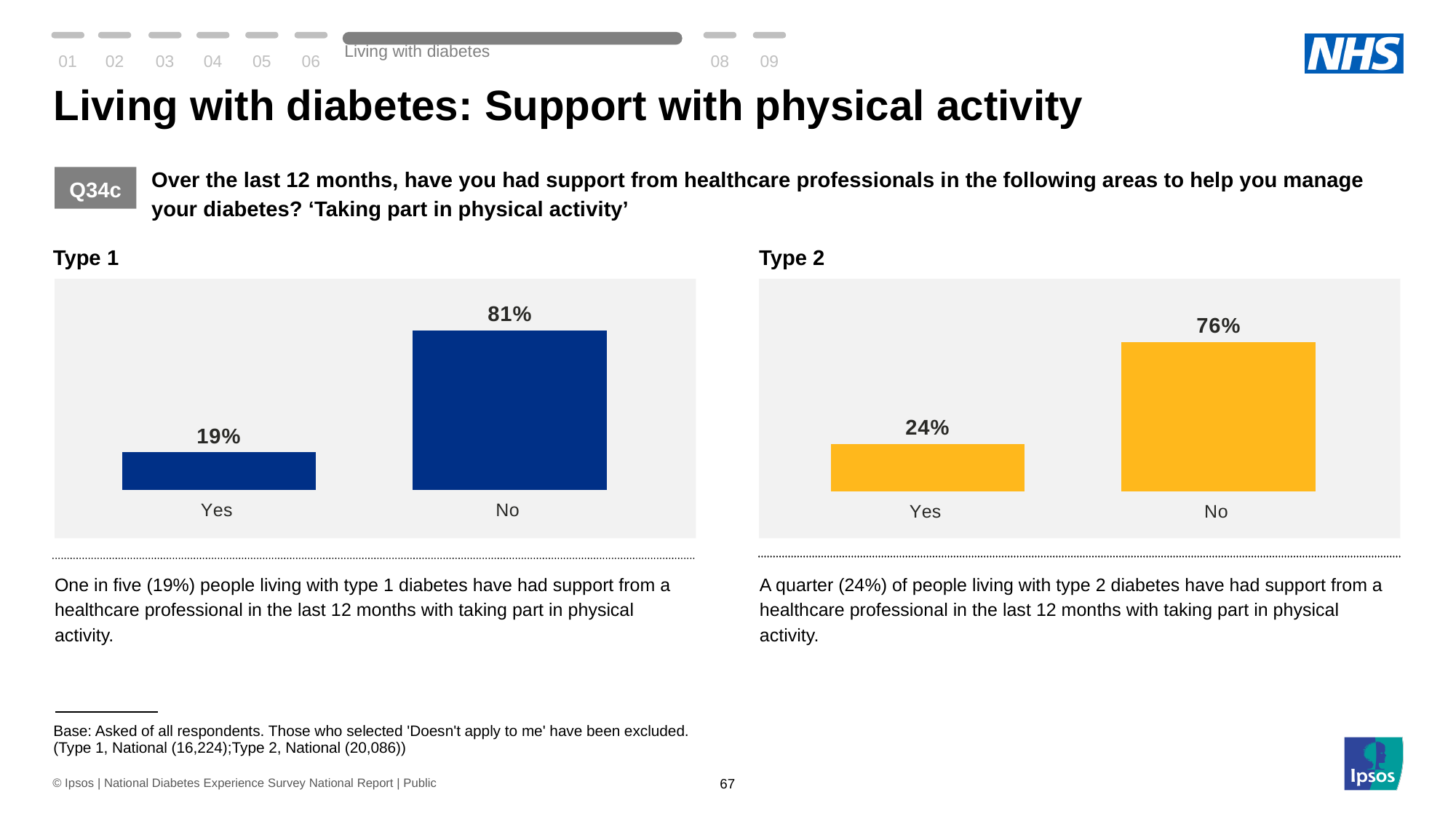
What kind of chart is the Type 2 chart? Bar chart In the Type 1 chart, what percentage of respondents answered Yes? 19% What colour are the bars in the Type 2 chart? Yellow In the Type 2 chart, what is the difference between the No and Yes percentages? 52% In the Type 1 chart, what percentage of respondents answered No? 81% In the Type 1 chart, which category has the highest value? No In the Type 2 chart, what percentage of respondents answered No? 76% How many categories are shown in the Type 1 chart? 2 In the Type 1 chart, what is the difference between the No and Yes percentages? 62% In the Type 2 chart, what percentage of respondents answered Yes? 24% In the Type 2 chart, which category has the lowest value? Yes Which is larger: the Yes value in the Type 1 chart or the Yes value in the Type 2 chart? Type 2